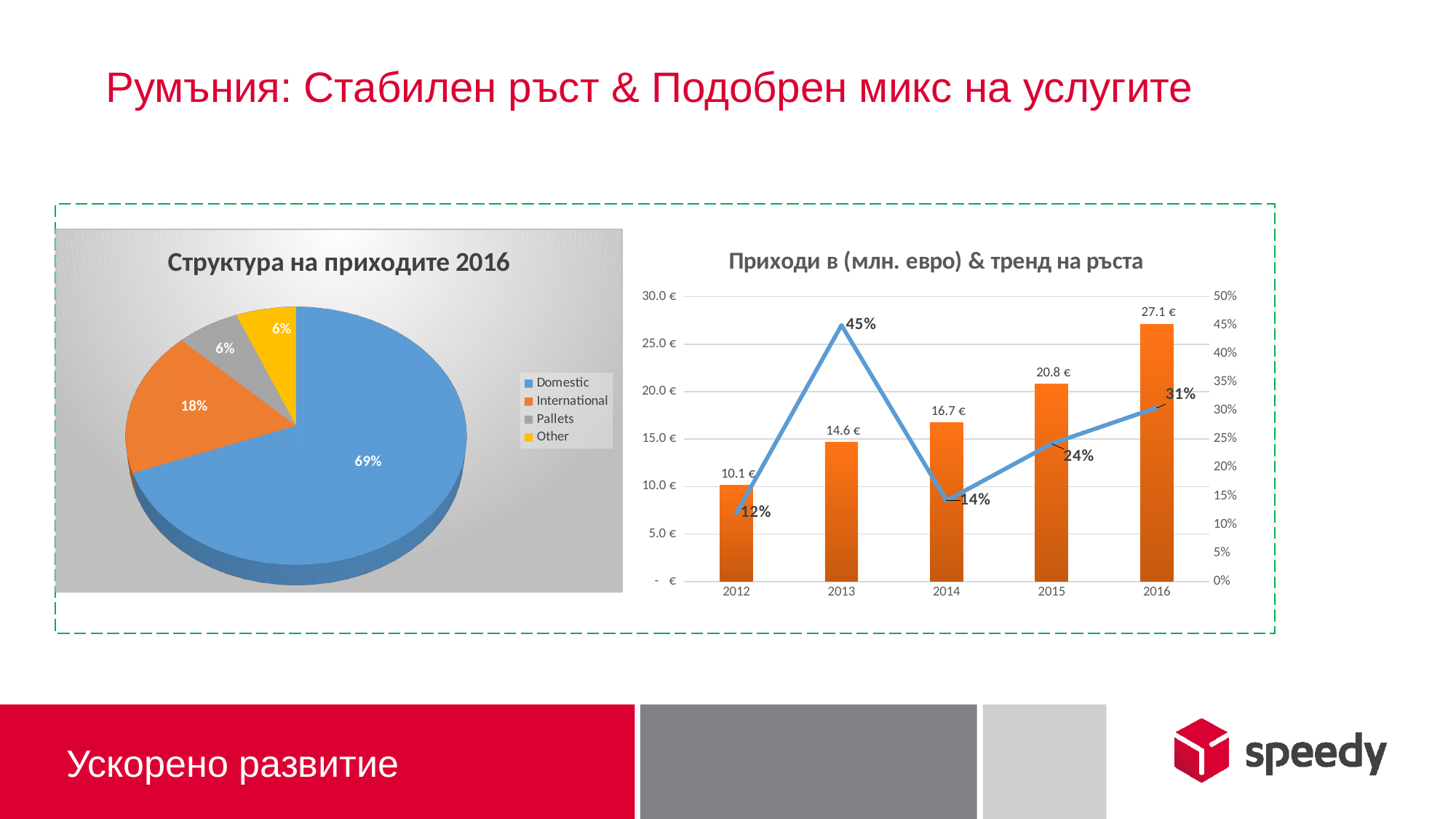
In the chart 'Приходи в (млн. евро) & тренд на ръста', what is the revenue value for 2012? 10.1 € In the chart 'Приходи в (млн. евро) & тренд на ръста', what growth rate is shown for 2013? 45% In the pie chart 'Структура на приходите 2016', what share does International have? 18% In the chart 'Приходи в (млн. евро) & тренд на ръста', what is the difference in revenue between 2016 and 2015? 6.3 € In the pie chart 'Структура на приходите 2016', how many categories does the legend list? 4 In the chart 'Приходи в (млн. евро) & тренд на ръста', do the revenue bars rise or fall from 2012 to 2016? rise In the pie chart 'Структура на приходите 2016', which category has the largest share? Domestic In the pie chart 'Структура на приходите 2016', what share does Domestic have? 69% In the chart 'Приходи в (млн. евро) & тренд на ръста', which year has the lowest growth rate on the line? 2012 In the chart 'Приходи в (млн. евро) & тренд на ръста', how many years are shown on the x axis? 5 In the pie chart 'Структура на приходите 2016', what is the difference between the Domestic and International shares? 51% In the chart 'Приходи в (млн. евро) & тренд на ръста', what is the revenue value for 2016? 27.1 €